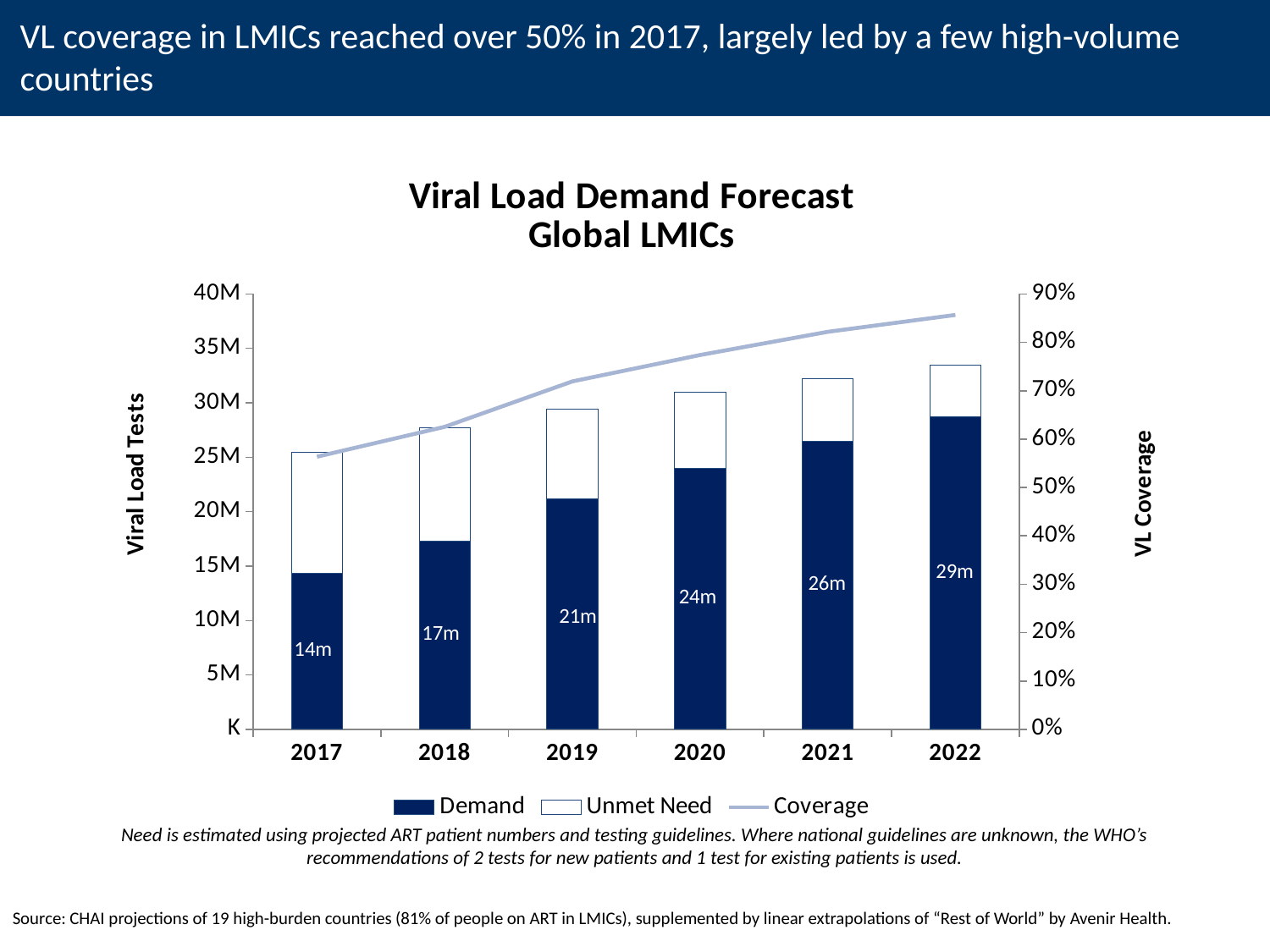
How many years are shown on the x axis? 6 What is the Demand value for 2022? 29m What is the Demand value for 2017? 14m Is the Coverage value for 2017 greater or less than 50%? greater Is the Coverage value for 2022 greater or less than 80%? greater Which year has the highest Demand? 2022 What is the Demand value for 2020? 24m Does the Demand rise or fall from 2017 to 2022? rise How many series does the legend list? 3 What is the difference between the Demand in 2022 and the Demand in 2017? 15m Which year has the lowest Demand? 2017 Which is larger, the Demand in 2019 or the Demand in 2021? 2021